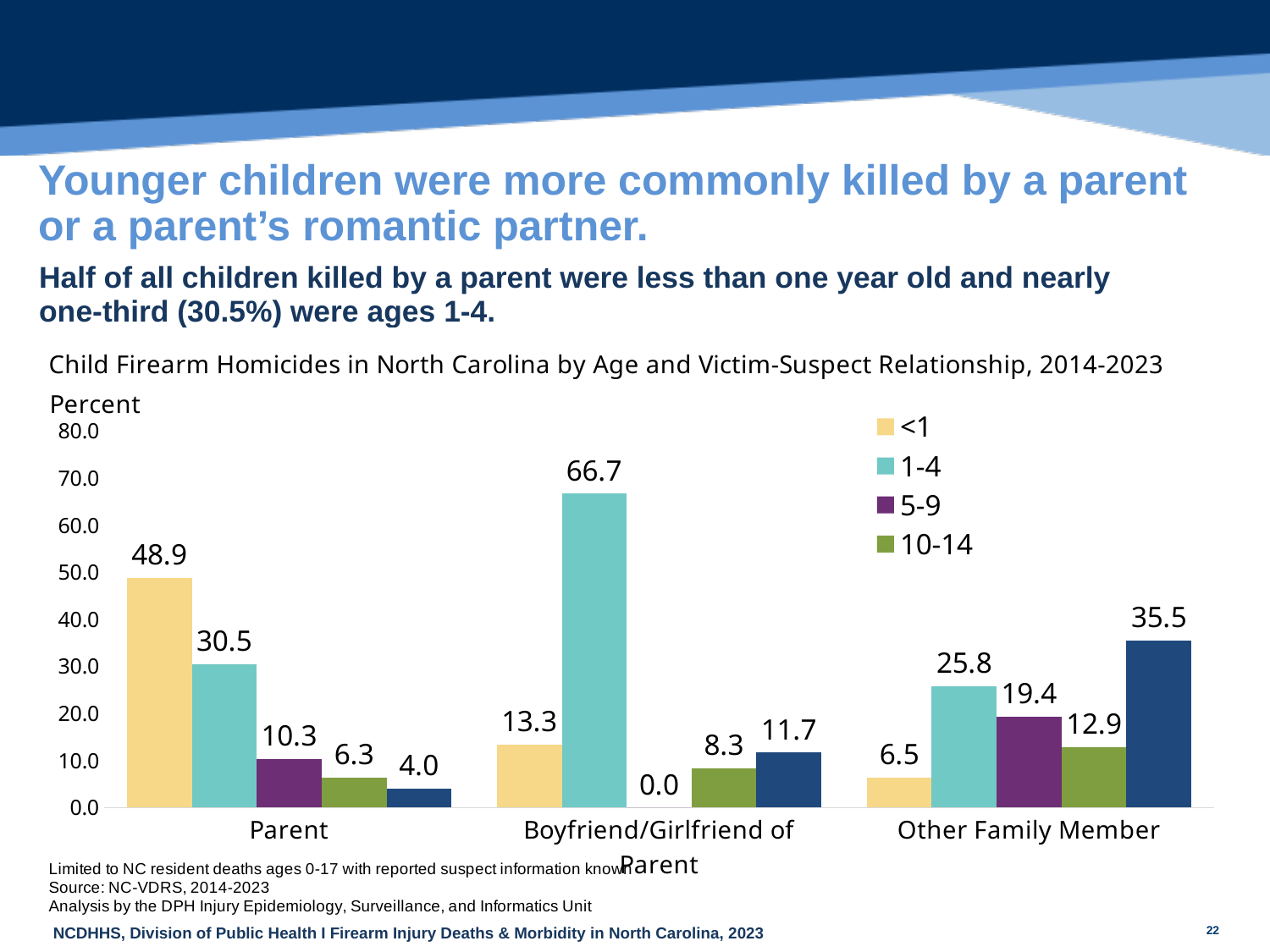
How many age groups does the legend list? 4 Which age group has the highest value in the Boyfriend/Girlfriend of Parent category? 1-4 What is the value for the 10-14 age group in the Parent category? 6.3 How many victim-suspect relationship categories are shown on the x axis? 3 What is the value for the 1-4 age group in the Boyfriend/Girlfriend of Parent category? 66.7 Which age group has the lowest value in the Boyfriend/Girlfriend of Parent category? 5-9 Is the value for the 1-4 age group larger in the Parent category or the Other Family Member category? Parent What is the value for the 5-9 age group in the Other Family Member category? 19.4 Is the value for the <1 age group in the Other Family Member category greater or less than 10.0? less What type of chart is shown on the slide? bar chart What is the difference between the <1 and 1-4 values in the Parent category? 18.4 What percent of child firearm homicides by a parent were victims aged <1? 48.9